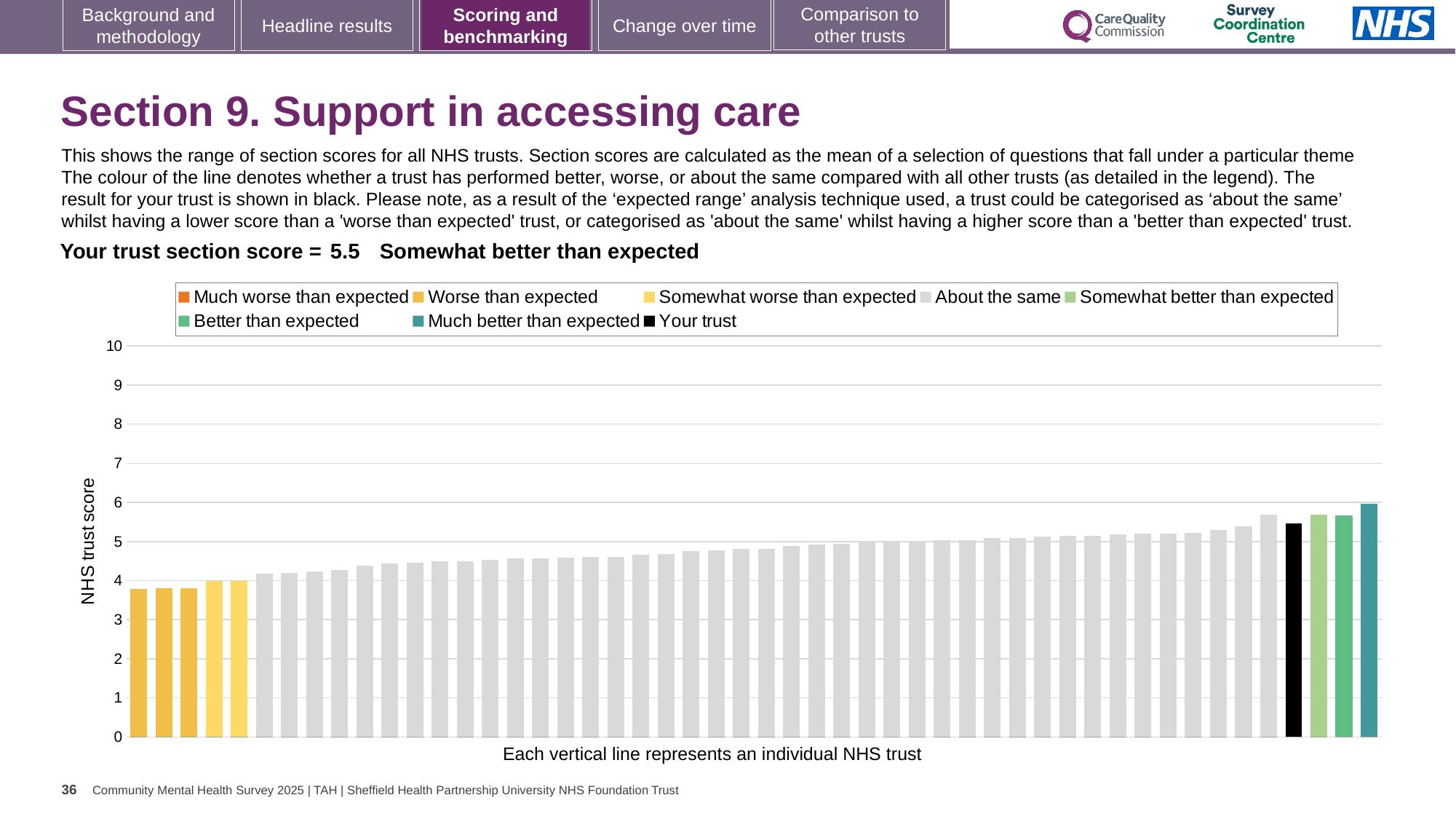
How many bars are coloured as 'Much better than expected'? 1 What is the section score for your trust shown on the slide? 5.5 What is the label on the vertical axis of the chart? NHS trust score How many entries does the chart legend list? 8 Which performance category is your trust placed in for Section 9? Somewhat better than expected How many bars are coloured as 'Worse than expected'? 3 Do the bar values rise or fall from left to right along the x axis? Rise Which is higher: the bar for your trust or the 'Much better than expected' bar? Much better than expected How many bars are coloured as 'Somewhat worse than expected'? 2 Is the value for your trust's bar greater or less than 5? greater Is the value of the lowest bar in the chart greater or less than 4? less What type of chart is shown on the slide? Bar chart